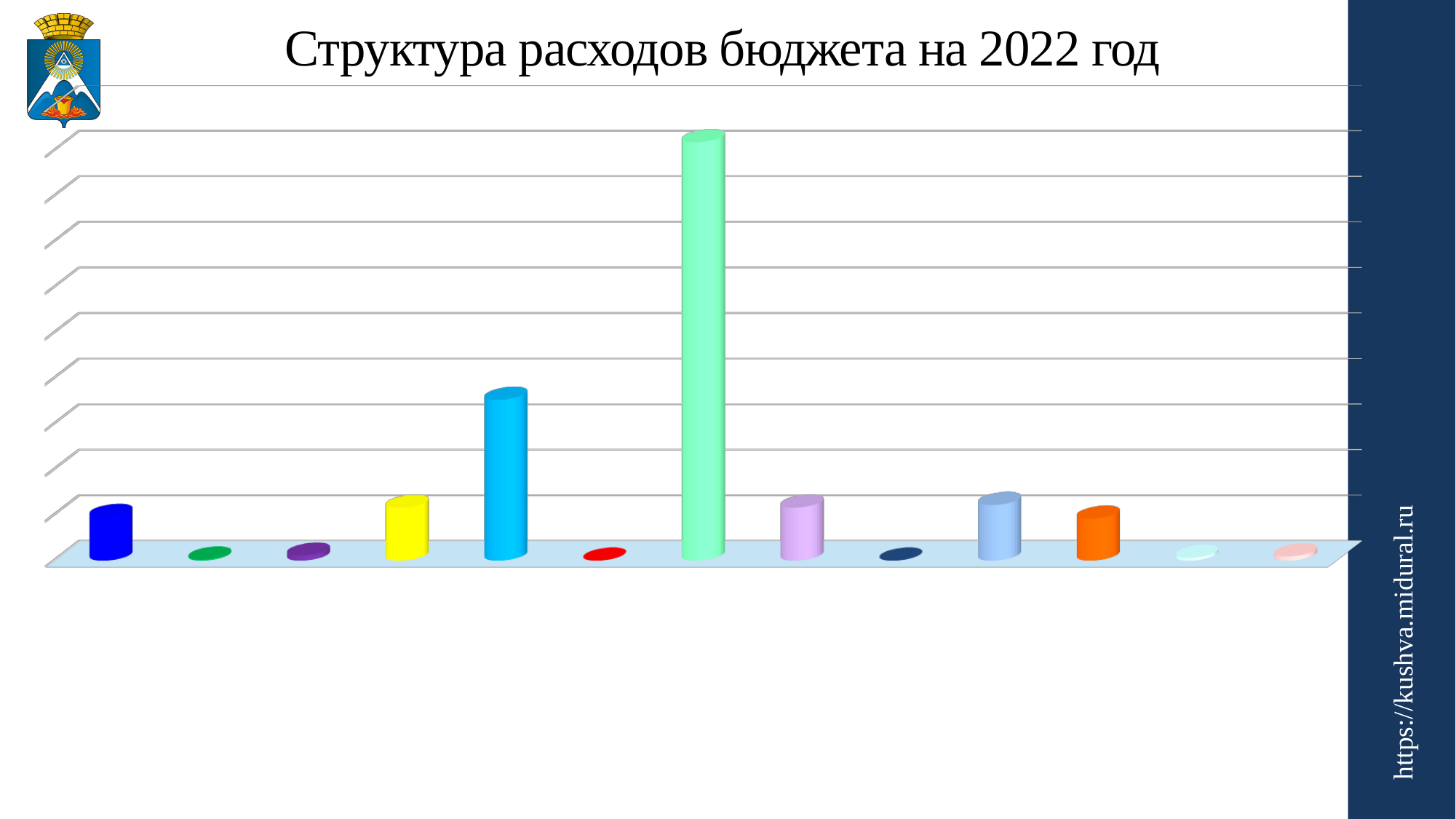
Which is taller, the cyan bar or the yellow bar? the cyan bar What is the title of the chart on the slide? Структура расходов бюджета на 2022 год Which is taller, the orange bar or the red bar? the orange bar How many bars are plotted in the chart? 13 Which bar in the chart is the tallest? the light green bar (seventh from the left) Which is taller, the dark blue bar on the far left or the green bar next to it? the dark blue bar Which bar is the second tallest in the chart? the cyan bar (fifth from the left) Does the chart display a legend? No What kind of chart is shown on the slide? bar chart